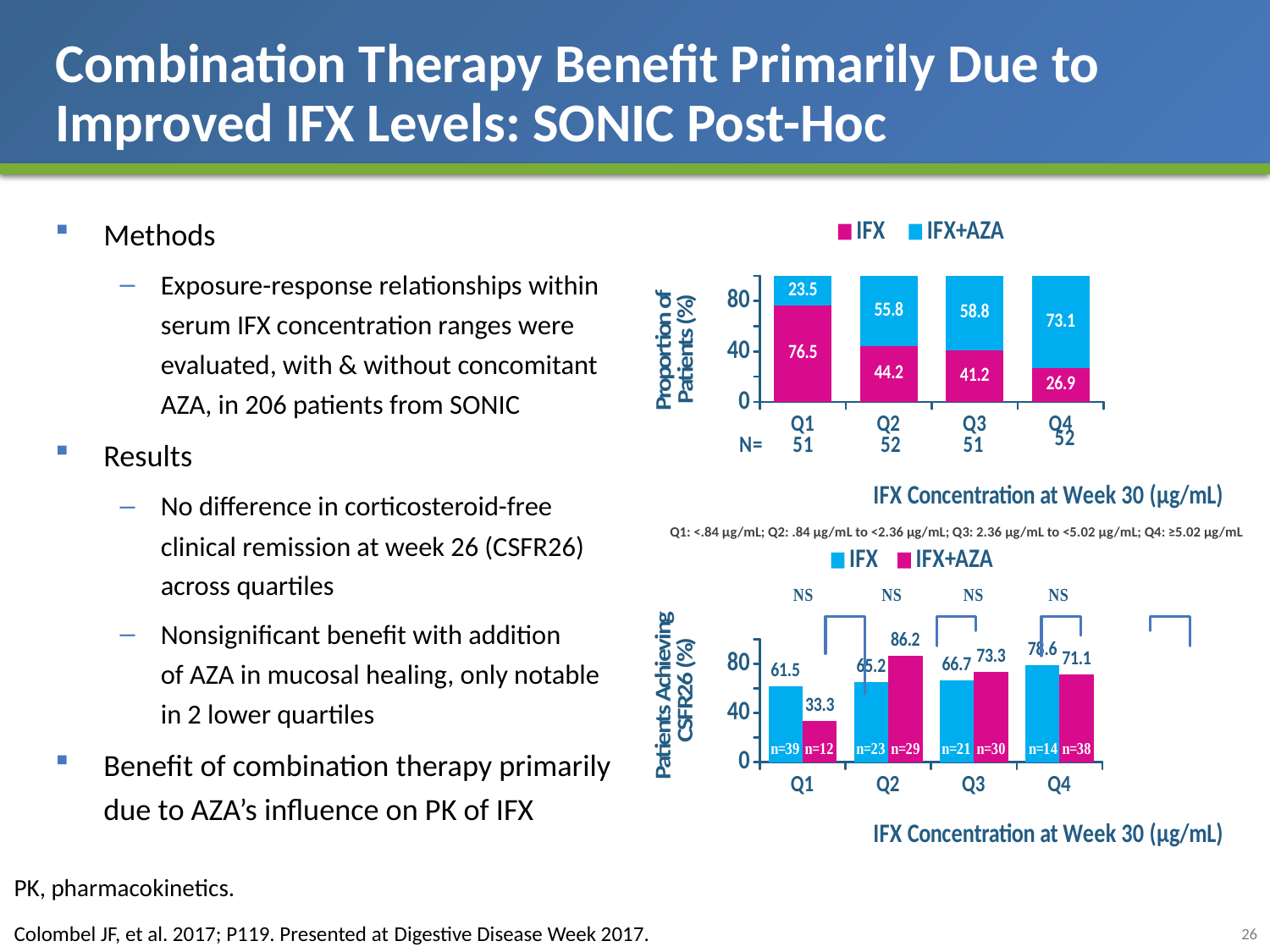
How many series does the legend of the bottom chart list? 2 In the bottom chart (Patients Achieving CSFR26), which is larger for Q3: IFX or IFX+AZA? IFX+AZA In the top chart (Proportion of Patients), which quartile has the lowest IFX value? Q4 In the top chart (Proportion of Patients), which quartile has the highest IFX+AZA value? Q4 In the top chart (Proportion of Patients), what is the total of the stacked bar for Q2? 100 In the top chart (Proportion of Patients), what is the IFX value for Q1? 76.5 In the bottom chart (Patients Achieving CSFR26), what is the IFX value for Q4? 78.6 In the bottom chart (Patients Achieving CSFR26), what is the IFX+AZA value for Q2? 86.2 In the bottom chart (Patients Achieving CSFR26), what is the difference between the IFX and IFX+AZA values for Q1? 28.2 In the top chart (Proportion of Patients), does the IFX value rise or fall from Q1 to Q4? fall In the bottom chart (Patients Achieving CSFR26), which quartile has the lowest IFX+AZA value? Q1 In the top chart (Proportion of Patients), what is the IFX+AZA value for Q4? 73.1